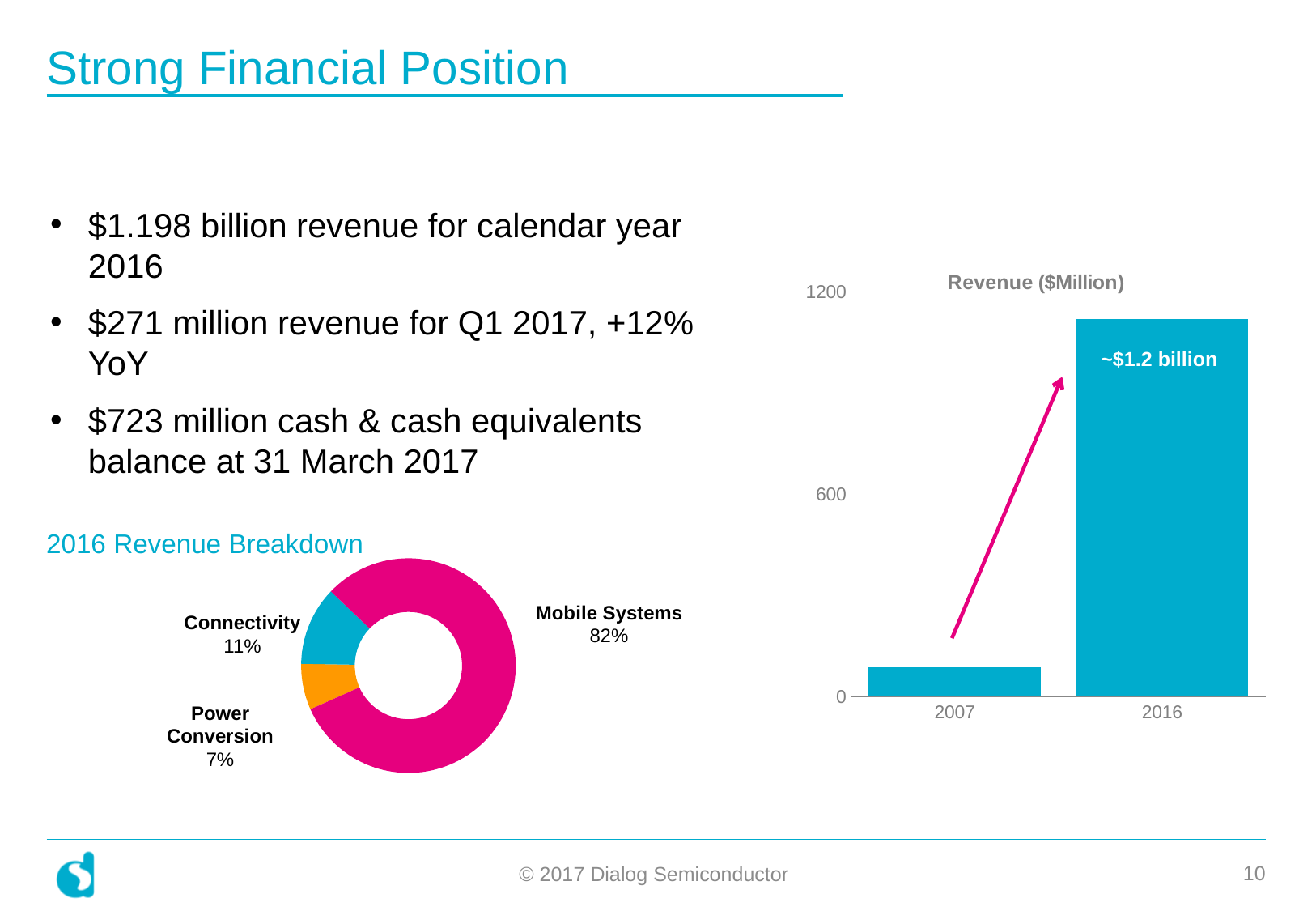
In the 2016 Revenue Breakdown chart, which segment has the smallest share? Power Conversion In the Revenue ($Million) chart, is the value for 2007 greater or less than 600? less How many segments are shown in the 2016 Revenue Breakdown chart? 3 In the 2016 Revenue Breakdown chart, what percentage is shown for Power Conversion? 7% In the 2016 Revenue Breakdown chart, which segment has the largest share? Mobile Systems In the Revenue ($Million) chart, which year has the higher revenue, 2007 or 2016? 2016 How many years are plotted in the Revenue ($Million) chart? 2 In the 2016 Revenue Breakdown chart, what percentage is shown for Connectivity? 11% What kind of chart is the Revenue ($Million) chart on the right? Bar chart In the 2016 Revenue Breakdown chart, what share of revenue comes from Mobile Systems? 82% What kind of chart is the 2016 Revenue Breakdown chart? Doughnut chart In the 2016 Revenue Breakdown chart, how many percentage points larger is Mobile Systems than Connectivity? 71 percentage points